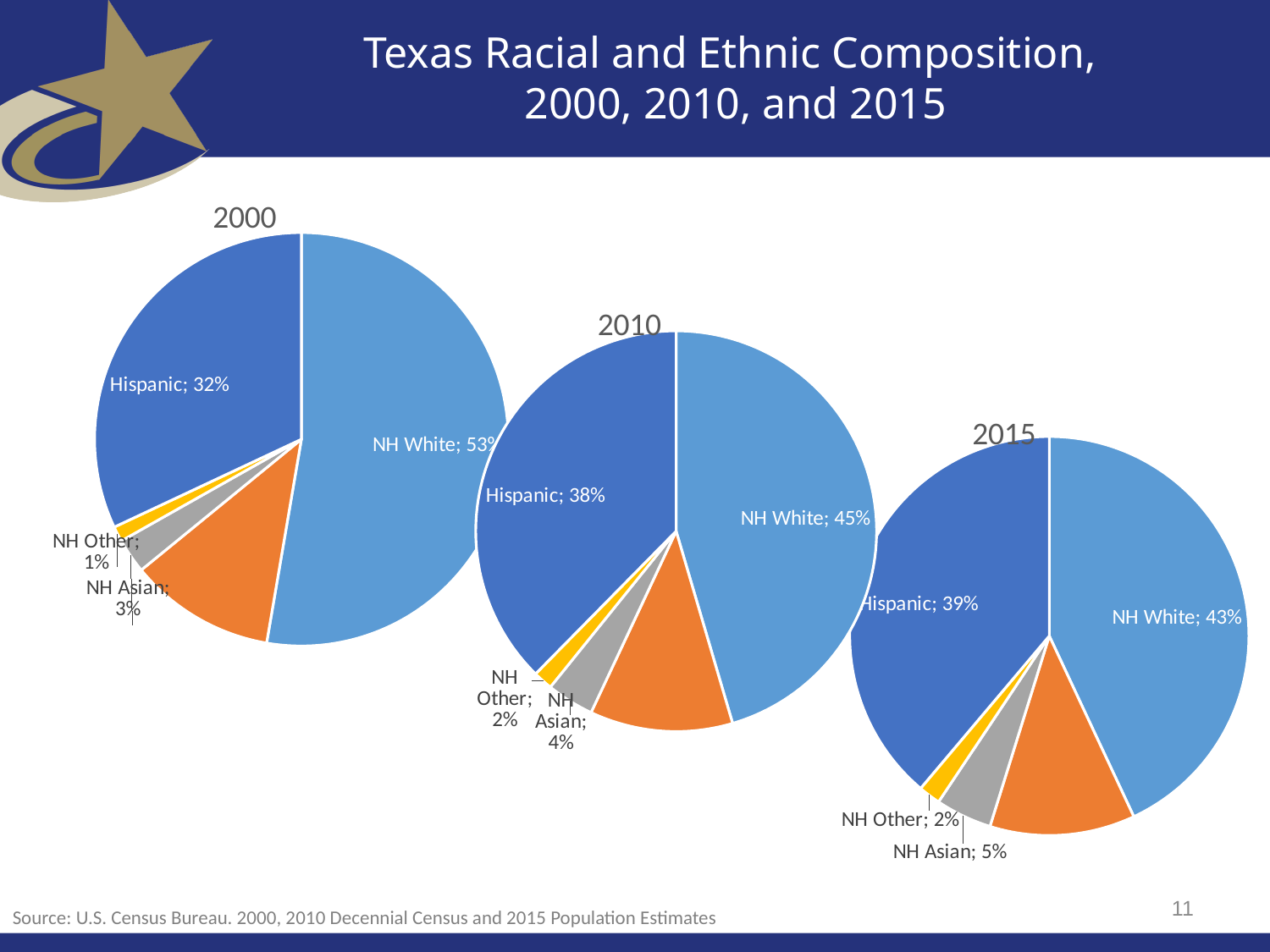
Which chart shows a larger Hispanic share, the 2000 pie chart or the 2015 pie chart? 2015 In the 2015 pie chart, what is the difference between the NH White share and the Hispanic share? 4% In the 2010 pie chart, which is larger, the NH White share or the Hispanic share? NH White How many slices does the 2010 pie chart have? 5 In the 2010 pie chart, which labelled group has the smallest share? NH Other In the 2015 pie chart, what share is NH Asian? 5% In the 2010 pie chart, what share is Hispanic? 38% What type of chart is used to show the 2000 composition? Pie chart In the 2000 pie chart, what is the difference between the NH White share and the Hispanic share? 21% In the 2000 pie chart, what share is NH White? 53% In the 2015 pie chart, what share is NH Other? 2% In the 2000 pie chart, which labelled group has the largest share? NH White